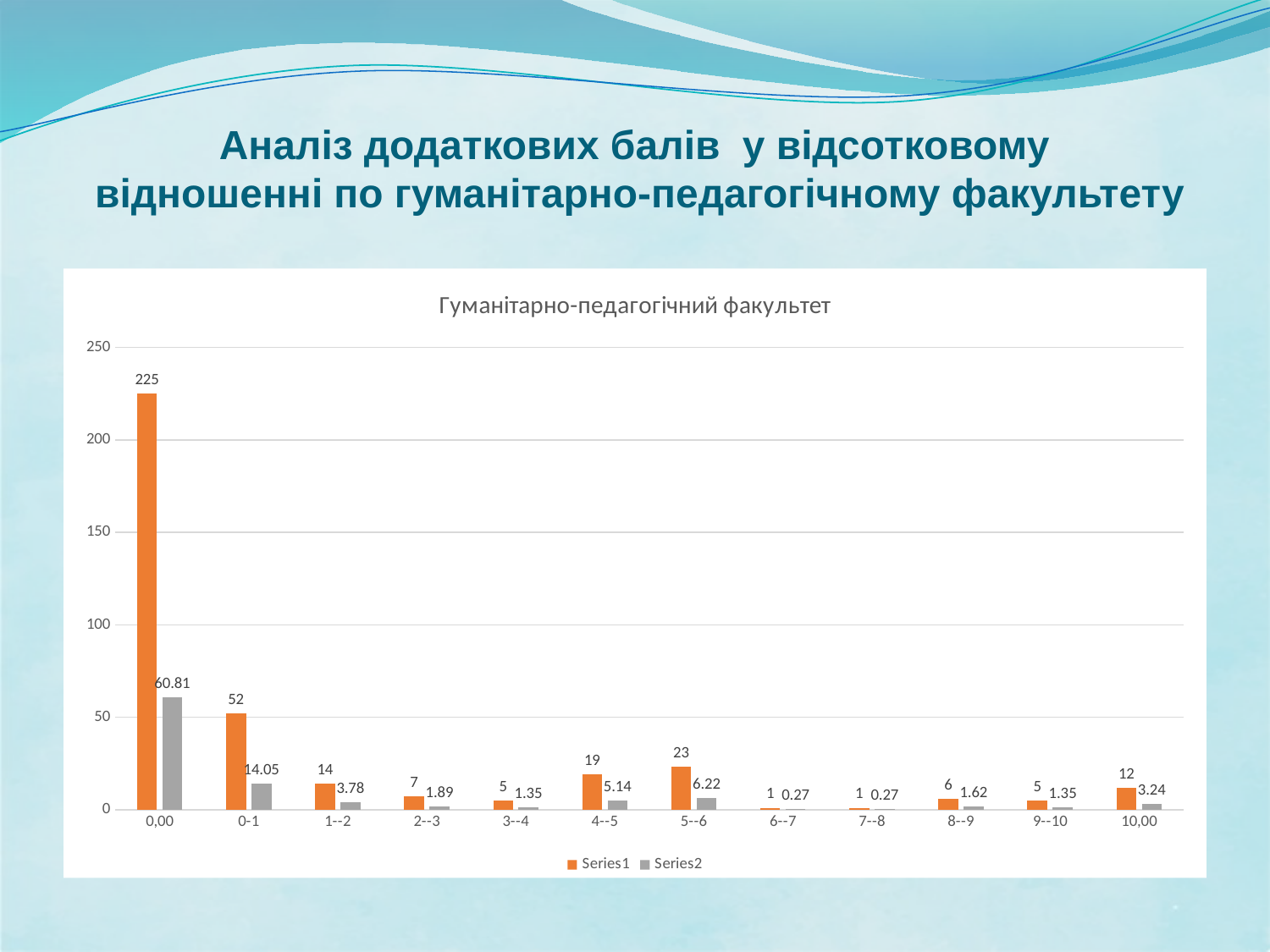
Is the Series2 value for 0,00 greater or less than 50? greater What is the Series1 value for the category 5--6? 23 Which category has the lowest Series2 value? 6--7 and 7--8 What is the difference between the Series1 values for 0,00 and 0-1? 173 How many categories are shown on the x axis? 12 How many series does the legend list? 2 What type of chart is shown on the slide? bar chart What is the Series1 value for the category 0,00? 225 What is the Series2 value for the category 0-1? 14.05 Which is larger, the Series1 value for 4--5 or for 5--6? 5--6 What is the Series2 value for the category 10,00? 3.24 Which category has the highest Series1 value? 0,00